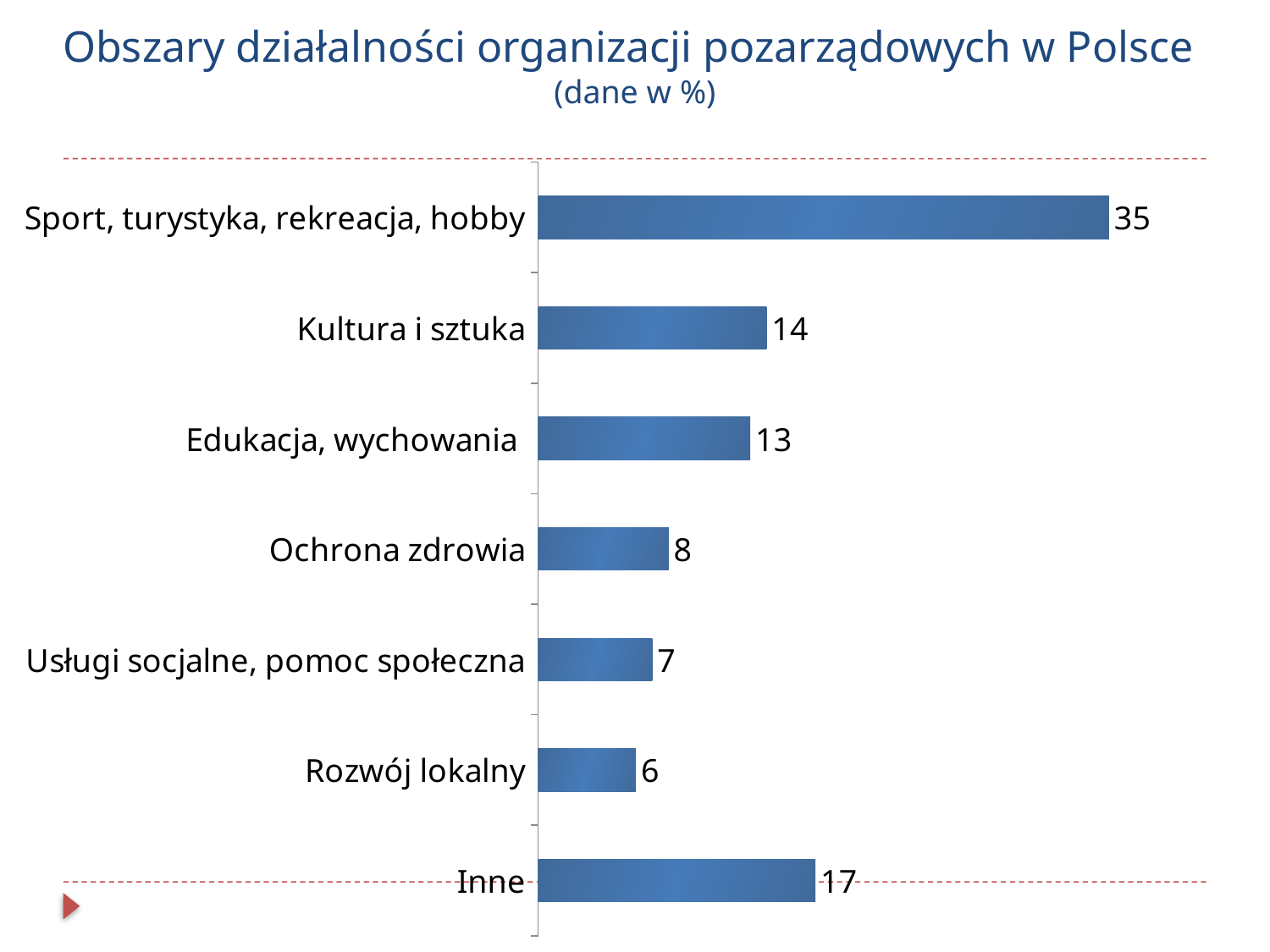
What is the value for Inne? 17 What kind of chart is shown on the slide? Bar chart What is the value for Kultura i sztuka? 14 What is the difference between the values for Edukacja, wychowania and Usługi socjalne, pomoc społeczna? 6 What is the value for Ochrona zdrowia? 8 What is the value for Sport, turystyka, rekreacja, hobby? 35 Which is larger, the value for Inne or the value for Kultura i sztuka? Inne Which category has the lowest value? Rozwój lokalny How many categories are shown in the chart? 7 What is the difference between the values for Sport, turystyka, rekreacja, hobby and Kultura i sztuka? 21 Which category has the highest value? Sport, turystyka, rekreacja, hobby What unit are the data given in, according to the subtitle? %